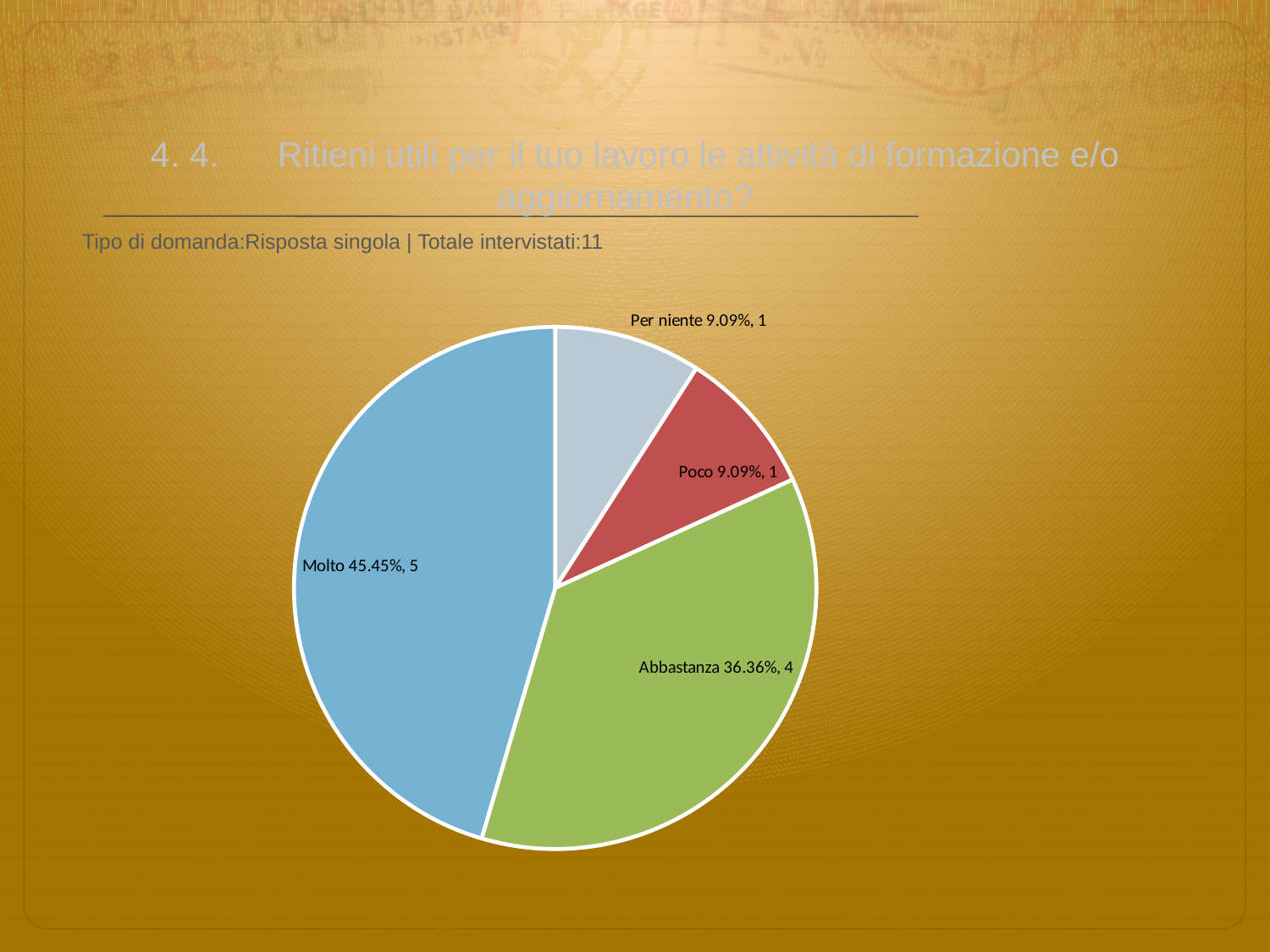
What percentage share does the Per niente slice have? 9.09% Which is larger, the Molto slice or the Abbastanza slice? Molto What is the total number of respondents across all slices? 11 How many respondents answered Abbastanza? 4 What colour is the Molto slice? blue Which category has the largest slice? Molto What kind of chart is shown on the slide? pie chart What is the difference in respondent count between Molto and Abbastanza? 1 What percentage share does the Abbastanza slice have? 36.36% What percentage share does the Molto slice have? 45.45% How many respondents answered Poco? 1 How many slices does the pie chart have? 4